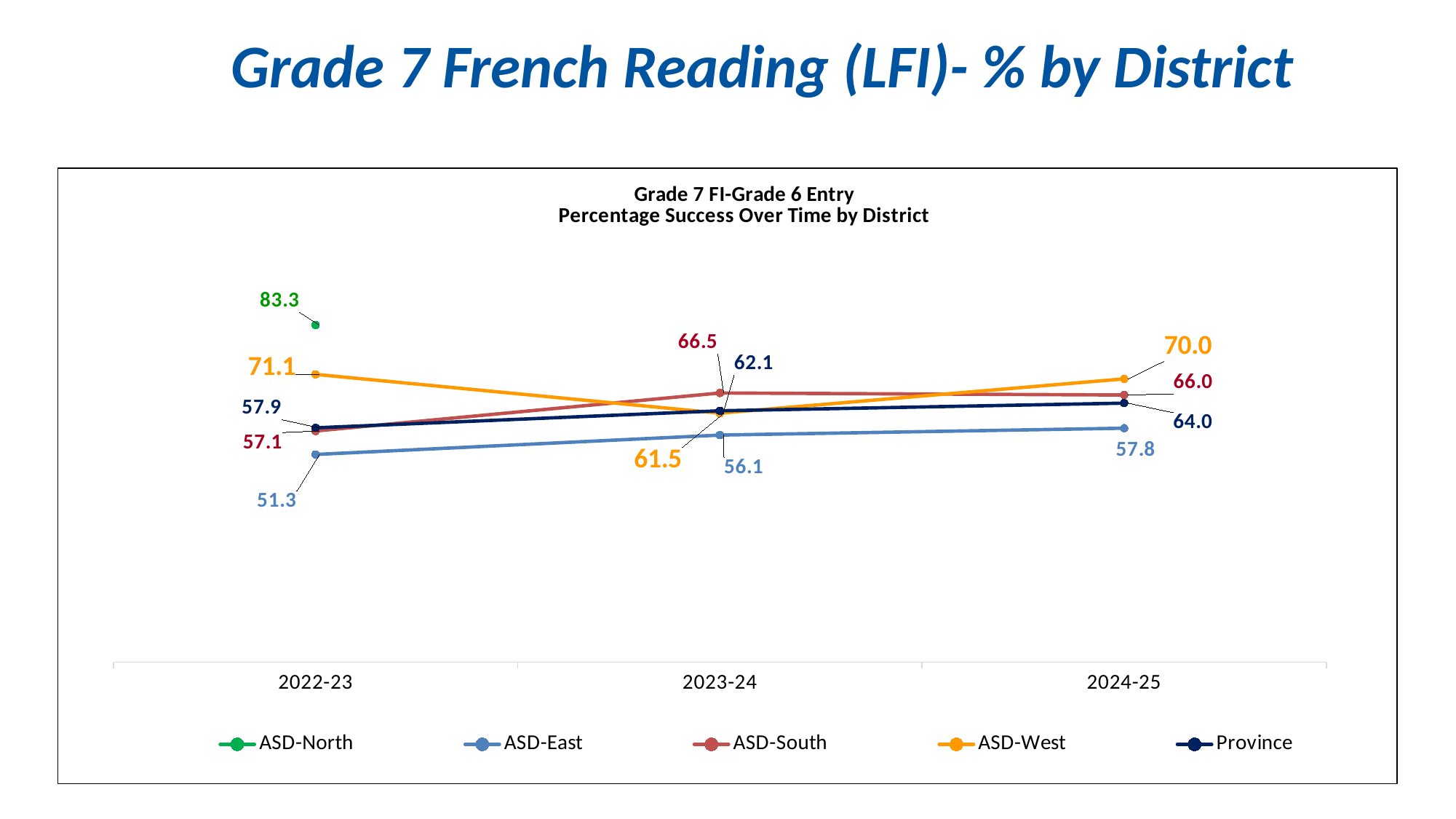
What is the value for ASD-West in 2024-25? 70.0 What is the value for Province in 2024-25? 64.0 What kind of chart is shown? Line chart Which is larger in 2023-24, ASD-South or ASD-West? ASD-South What is the difference between ASD-West and ASD-East in 2024-25? 12.2 What is the value for ASD-East in 2023-24? 56.1 Which series has the lowest value in 2024-25? ASD-East Which series has the highest value in 2022-23? ASD-North Does the ASD-East line rise or fall from 2022-23 to 2024-25? Rise What is the value for ASD-North in 2022-23? 83.3 How many series does the legend list? 5 How many school years are shown on the x axis? 3